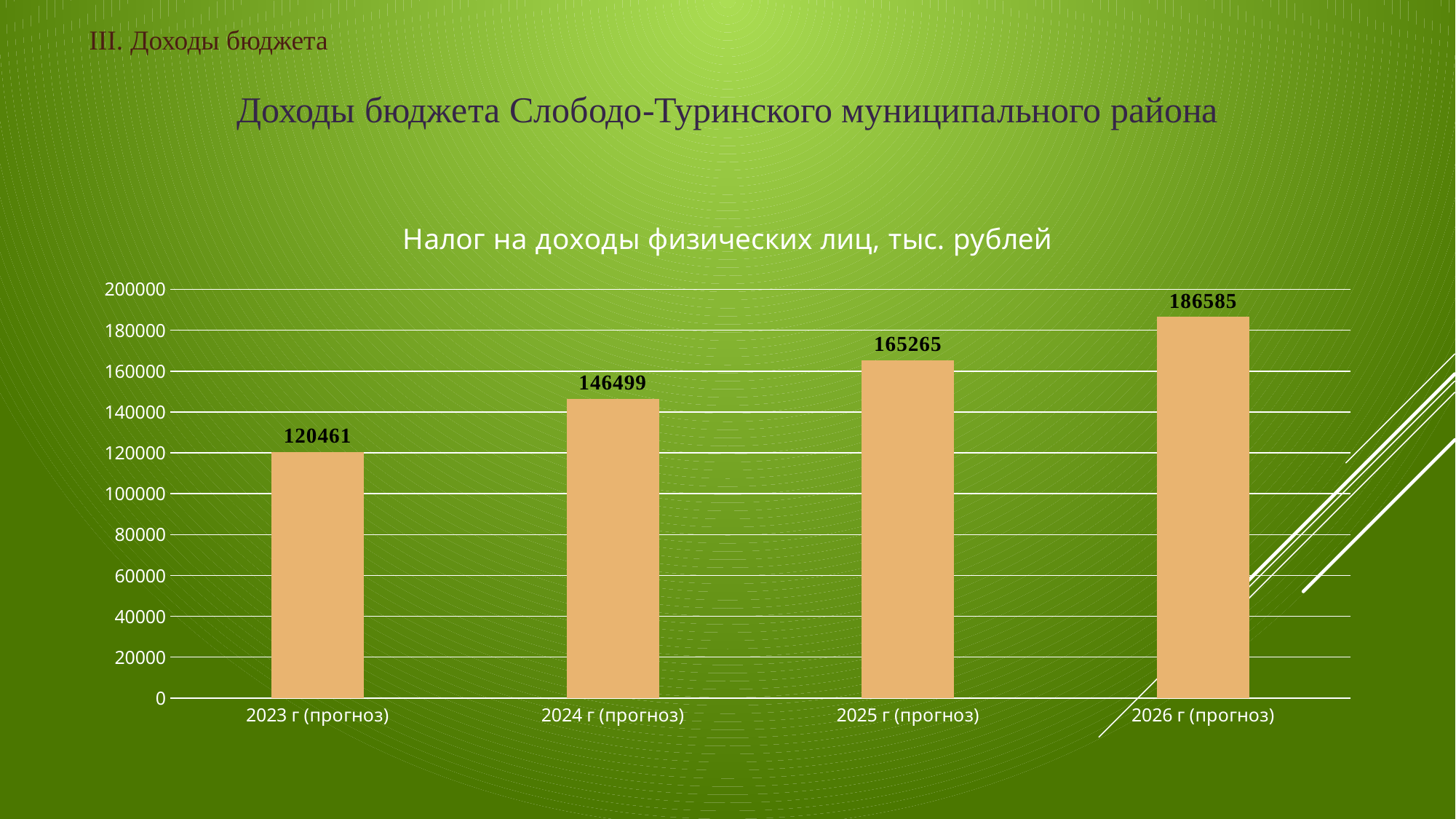
Is the value for 2025 г (прогноз) greater or less than 160000? greater What is the value for 2026 г (прогноз)? 186585 Which year has the lowest value? 2023 г (прогноз) What is the value for 2024 г (прогноз)? 146499 How many years are shown on the x axis? 4 What is the difference between the values for 2024 г (прогноз) and 2023 г (прогноз)? 26038 Which is larger, the value for 2025 г (прогноз) or the value for 2024 г (прогноз)? 2025 г (прогноз) What kind of chart is this? bar chart Which year has the highest value? 2026 г (прогноз) What is the difference between the values for 2026 г (прогноз) and 2025 г (прогноз)? 21320 What is the value for 2023 г (прогноз)? 120461 Do the values rise or fall from 2023 to 2026? rise